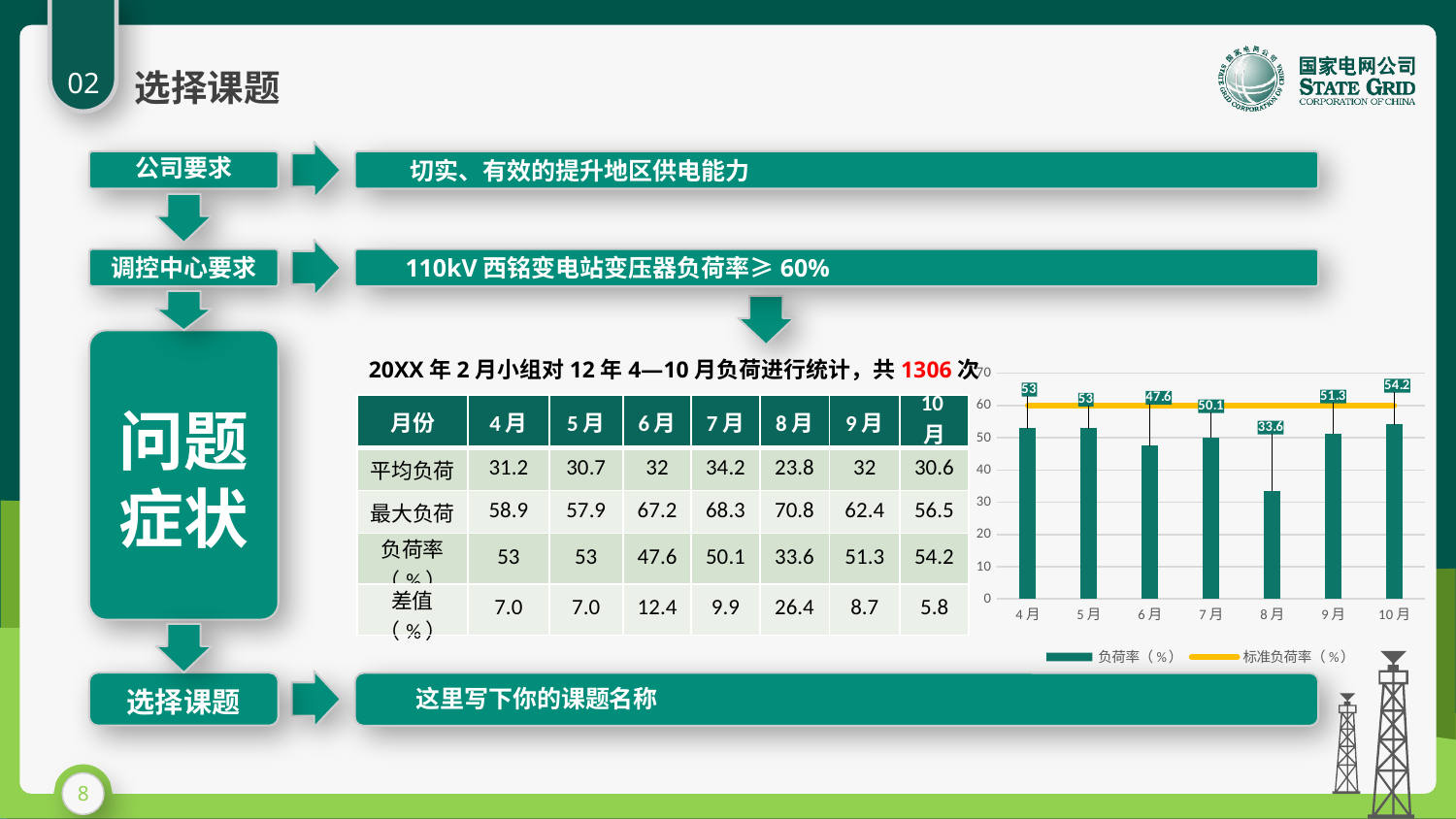
In the bar chart, which month has the highest 负荷率（%）? 10月 How many series does the legend of the bar chart list? 2 In the bar chart, which is larger, the 负荷率（%） for 7月 or for 9月? 9月 In the bar chart, what is the difference between the 负荷率（%） values for 10月 and 8月? 20.6 In the bar chart, which month has the lowest 负荷率（%）? 8月 In the bar chart, what does the yellow line in the legend represent? 标准负荷率（%） What type of chart is shown on the right side of the slide? combination bar and line chart In the bar chart, what is the 负荷率（%） value for 6月? 47.6 In the bar chart, what is the 负荷率（%） value for 10月? 54.2 How many months are shown on the x axis of the bar chart? 7 In the bar chart, what is the 负荷率（%） value for 8月? 33.6 In the bar chart, is the 负荷率（%） value for 4月 greater or less than 60? less